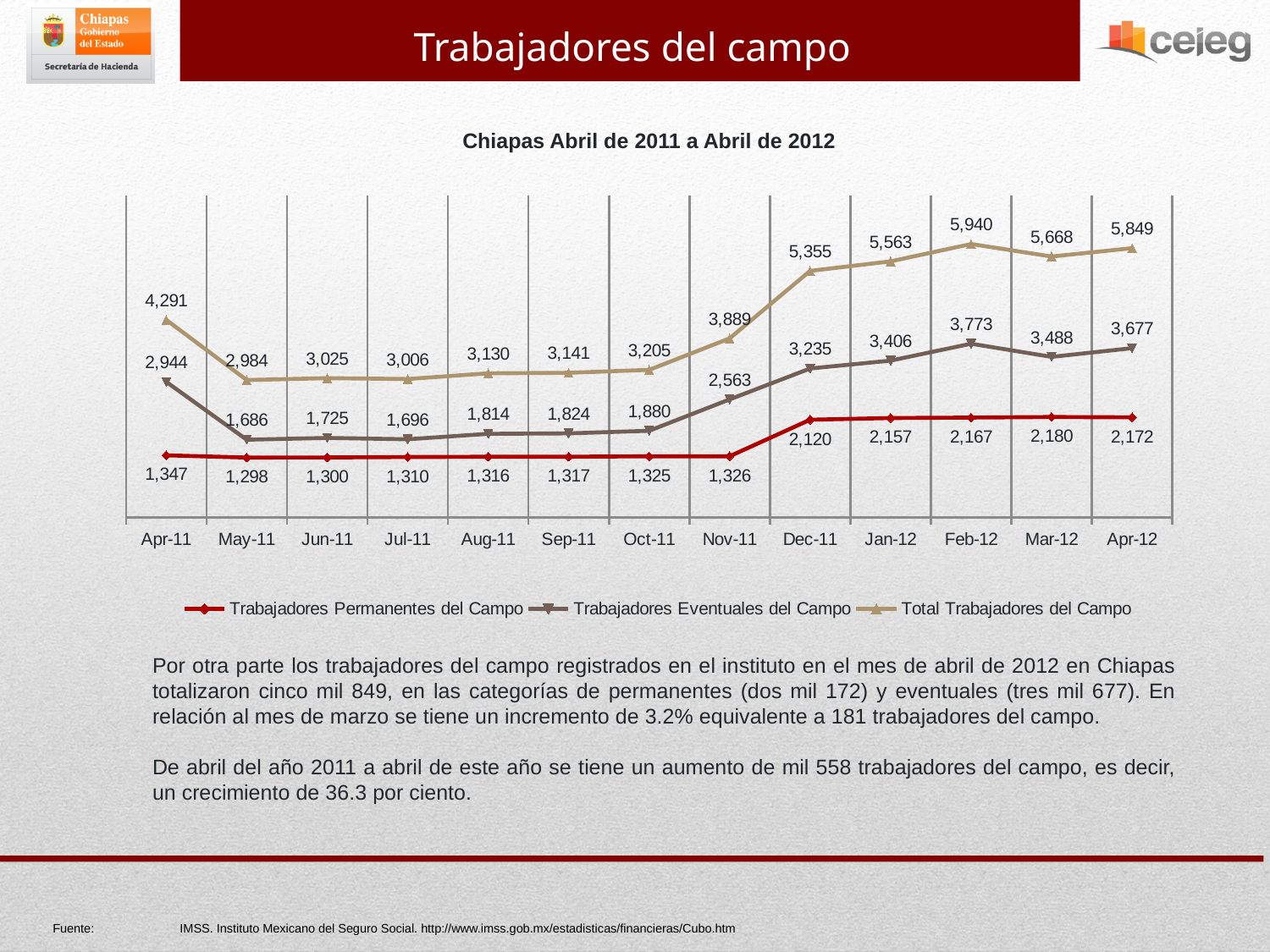
What is the difference between Total Trabajadores del Campo in Apr-12 and Mar-12? 181 Which is larger: Trabajadores Eventuales del Campo in Feb-12 or in Apr-12? Feb-12 What type of chart is shown on the slide? Line chart How many series does the legend list? 3 What is the value of Trabajadores Permanentes del Campo in Dec-11? 2,120 How many months are plotted along the x axis? 13 In which month is Trabajadores Permanentes del Campo lowest? May-11 What is the value of Total Trabajadores del Campo in Apr-12? 5,849 Does Trabajadores Permanentes del Campo rise or fall between Nov-11 and Dec-11? Rise In which month is Total Trabajadores del Campo highest? Feb-12 What is the title of the chart? Chiapas Abril de 2011 a Abril de 2012 What is the value of Trabajadores Eventuales del Campo in Nov-11? 2,563